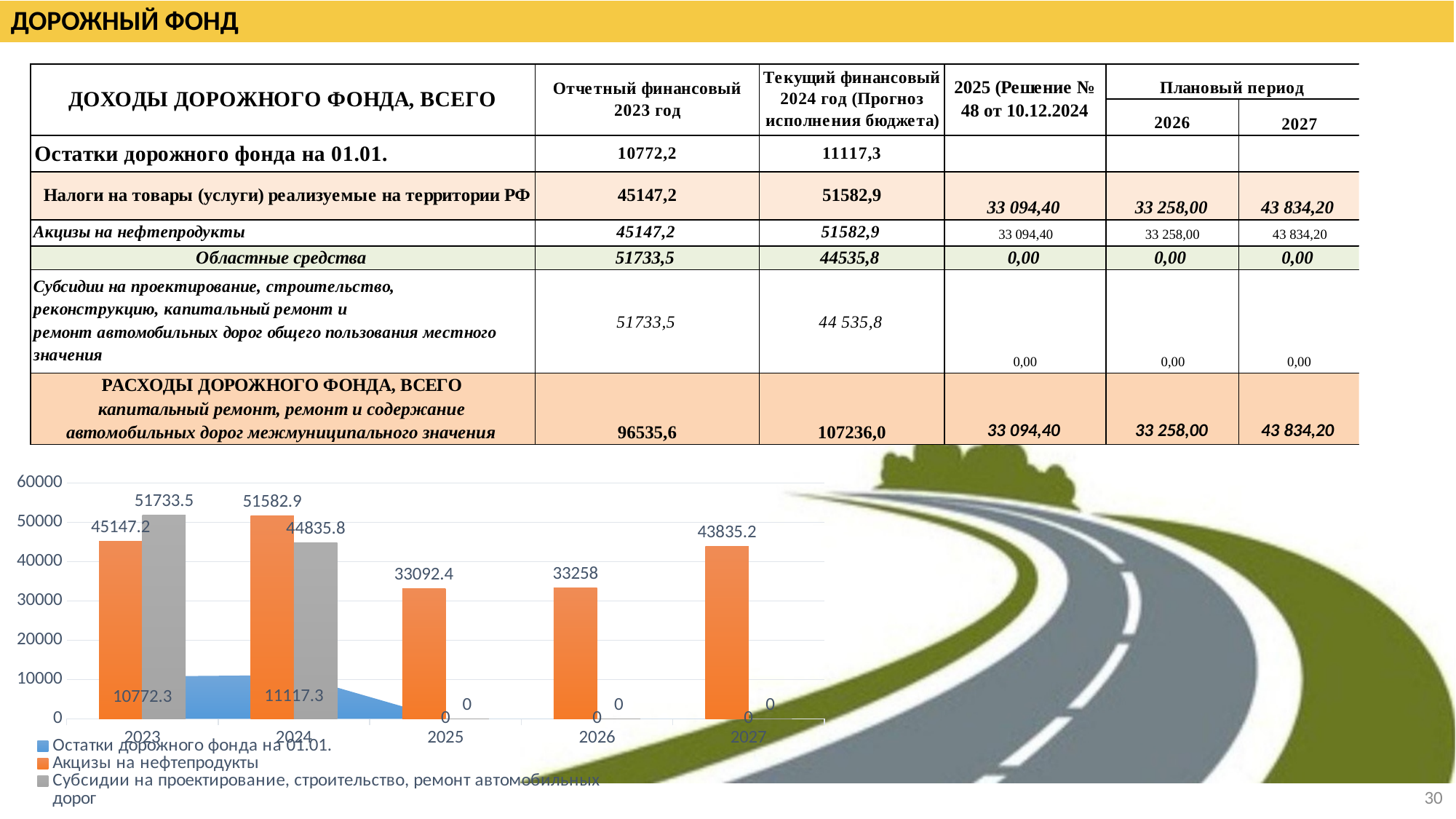
In the chart, is the value of Акцизы на нефтепродукты for 2026 greater or less than 30000? greater How many series does the chart legend list? 3 In the chart, which year has the highest value for Акцизы на нефтепродукты? 2024 In the chart, which is larger for 2023: Акцизы на нефтепродукты or Субсидии на проектирование, строительство, ремонт автомобильных дорог? Субсидии на проектирование, строительство, ремонт автомобильных дорог In the chart, what is the value of Остатки дорожного фонда на 01.01. for 2024? 11117.3 In the chart, what is the value of Акцизы на нефтепродукты for 2027? 43835.2 In the chart, what is the difference between the Акцизы на нефтепродукты values for 2024 and 2023? 6435.7 In the chart, which year has the lowest value for Акцизы на нефтепродукты? 2025 In the chart, what is the value of Акцизы на нефтепродукты for 2023? 45147.2 In the chart, what colour represents Акцизы на нефтепродукты? Orange How many years are shown on the x axis of the chart? 5 In the chart, what is the value of Субсидии на проектирование, строительство, ремонт автомобильных дорог for 2024? 44835.8